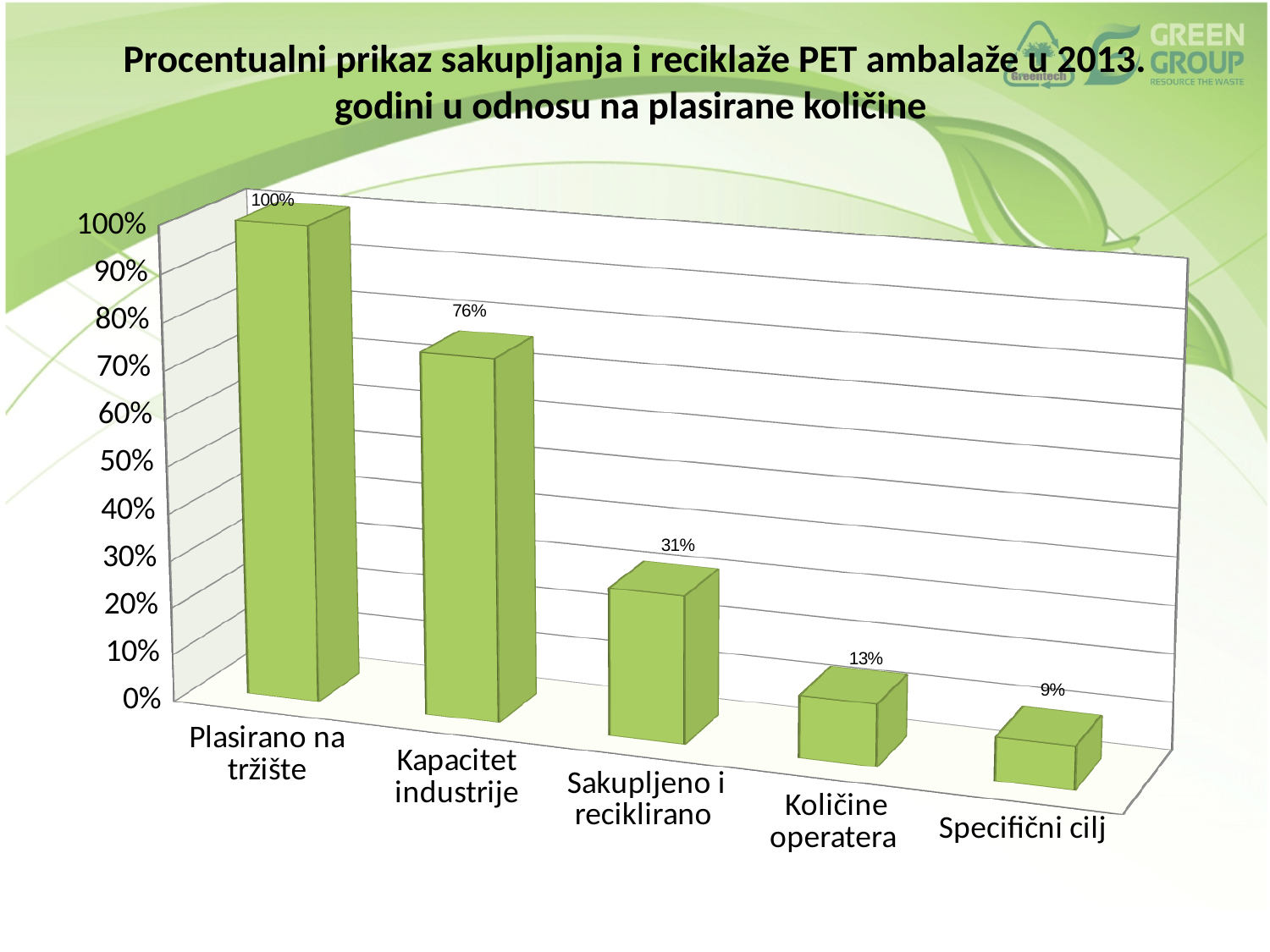
Which category has the lowest value? Specifični cilj Which category has the highest value? Plasirano na tržište What is the value for Sakupljeno i reciklirano? 31% Do the values rise or fall from left to right along the x axis? Fall What is the difference between the values for Sakupljeno i reciklirano and Količine operatera? 18% Which is larger, the value for Sakupljeno i reciklirano or the value for Specifični cilj? Sakupljeno i reciklirano What is the value for Količine operatera? 13% What is the value for Specifični cilj? 9% What is the difference between the values for Plasirano na tržište and Kapacitet industrije? 24% What is the value for Kapacitet industrije? 76% How many categories are shown in the chart? 5 What kind of chart is shown on the slide? Bar chart